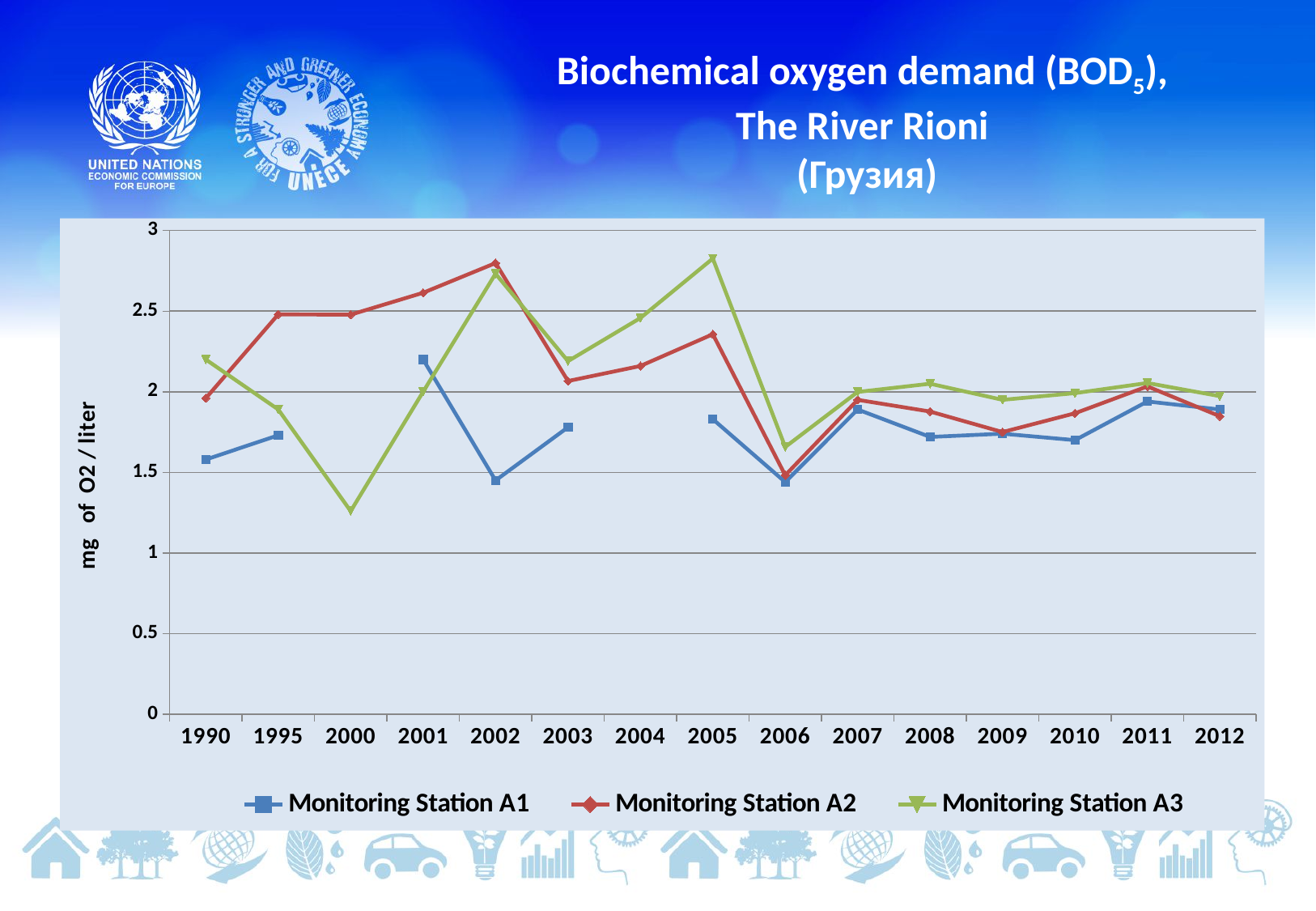
Does the value for Monitoring Station A3 rise or fall from 2000 to 2002? rise Is the value for Monitoring Station A1 in 2001 greater or less than 2? greater Is the value for Monitoring Station A3 in 2005 greater or less than 2.5? greater Is the value for Monitoring Station A3 in 2000 greater or less than 1.5? less In which year does Monitoring Station A3 reach its lowest value? 2000 How many years are shown on the x axis? 15 What is the label of the y axis? mg of O2 / liter In which year does Monitoring Station A3 reach its highest value? 2005 What kind of chart is shown on the slide? line chart How many series does the legend list? 3 In 2000, which is larger: the value for Monitoring Station A2 or Monitoring Station A3? Monitoring Station A2